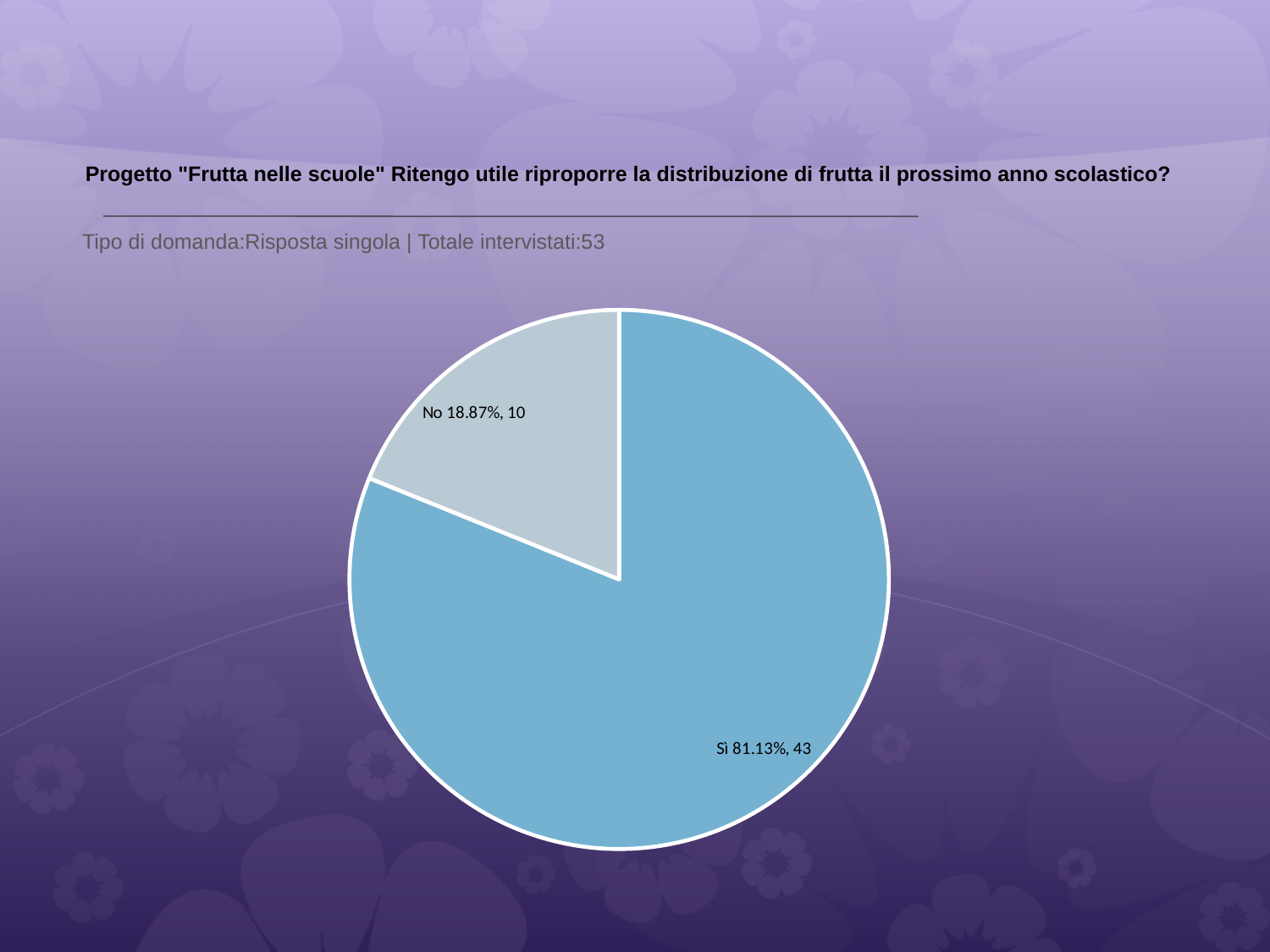
What is the total number of respondents shown on the slide? 53 What is the difference in number of respondents between "Sì" and "No"? 33 Which response has the largest share of the pie? Sì How many slices does the pie chart have? 2 Which response has the smallest share of the pie? No How many respondents answered "Sì"? 43 What percentage of respondents answered "No"? 18.87% What kind of chart is shown on the slide? pie chart Which response received more respondents, "Sì" or "No"? Sì What colour is the "Sì" slice of the pie chart? blue How many respondents answered "No"? 10 What percentage of respondents answered "Sì"? 81.13%